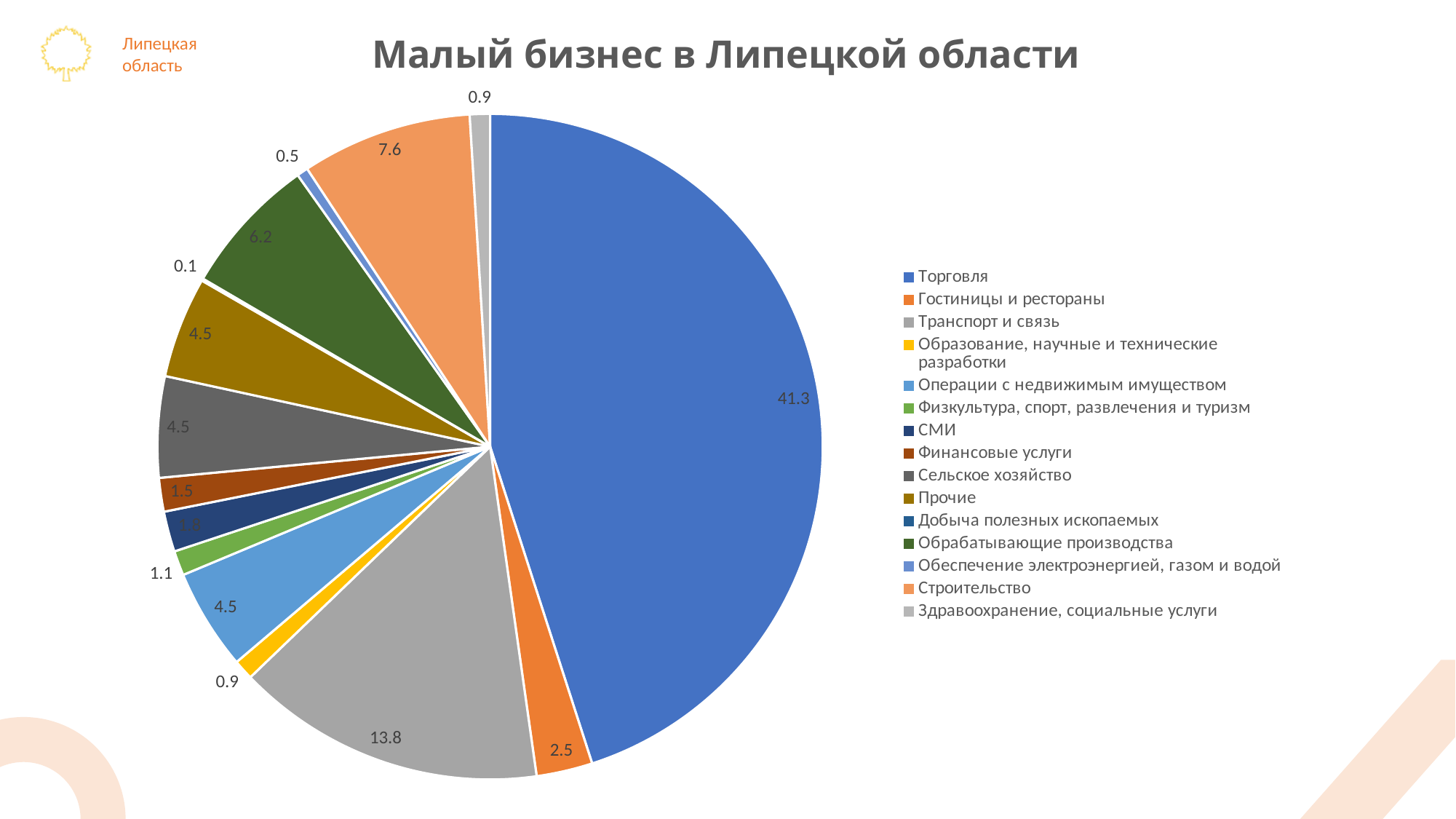
What is the value shown for Обрабатывающие производства? 6.2 Which category has the smallest slice of the pie? Добыча полезных ископаемых Which category has the largest slice of the pie? Торговля What is the value shown for Строительство? 7.6 How many categories does the legend list? 15 What is the value shown for Гостиницы и рестораны? 2.5 What is the value shown for Транспорт и связь? 13.8 What is the difference between the values for Торговля and Транспорт и связь? 27.5 Which is larger, the value for Строительство or the value for Обрабатывающие производства? Строительство What is the value shown for Торговля? 41.3 What kind of chart is shown on the slide? pie chart What is the title of the chart? Малый бизнес в Липецкой области